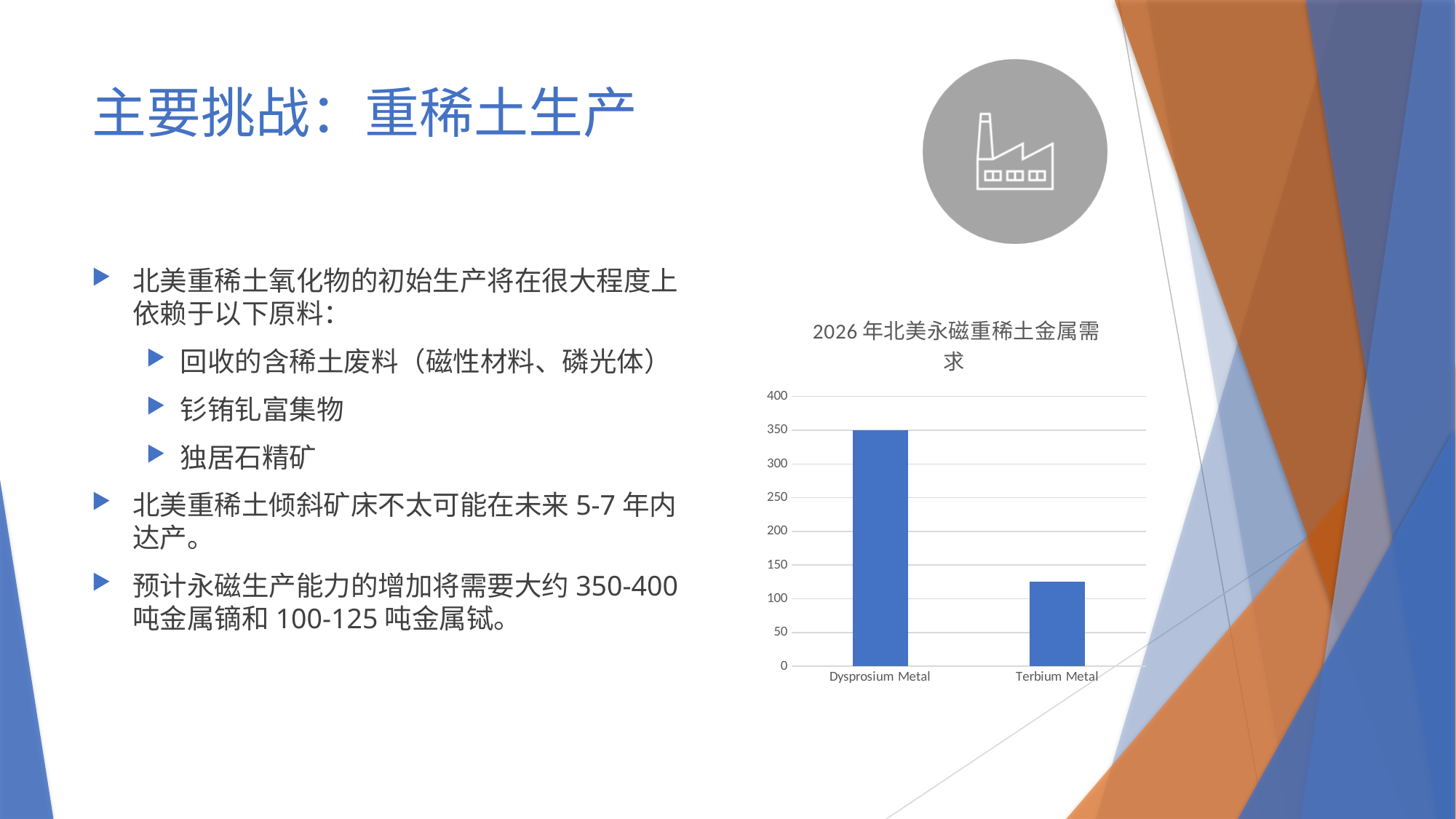
What is the highest value shown on the chart's vertical axis? 400 What is the value for Dysprosium Metal? 350 Is the value for Dysprosium Metal greater or less than 300? greater Which is larger, the value for Dysprosium Metal or the value for Terbium Metal? Dysprosium Metal Which category has the highest value in the chart? Dysprosium Metal What kind of chart is shown on the slide? bar chart What is the title of the chart? 2026 年北美永磁重稀土金属需求 How many categories does the chart show? 2 Is the value for Terbium Metal greater or less than 100? greater Which category has the lowest value in the chart? Terbium Metal Is the value for Terbium Metal greater or less than 150? less